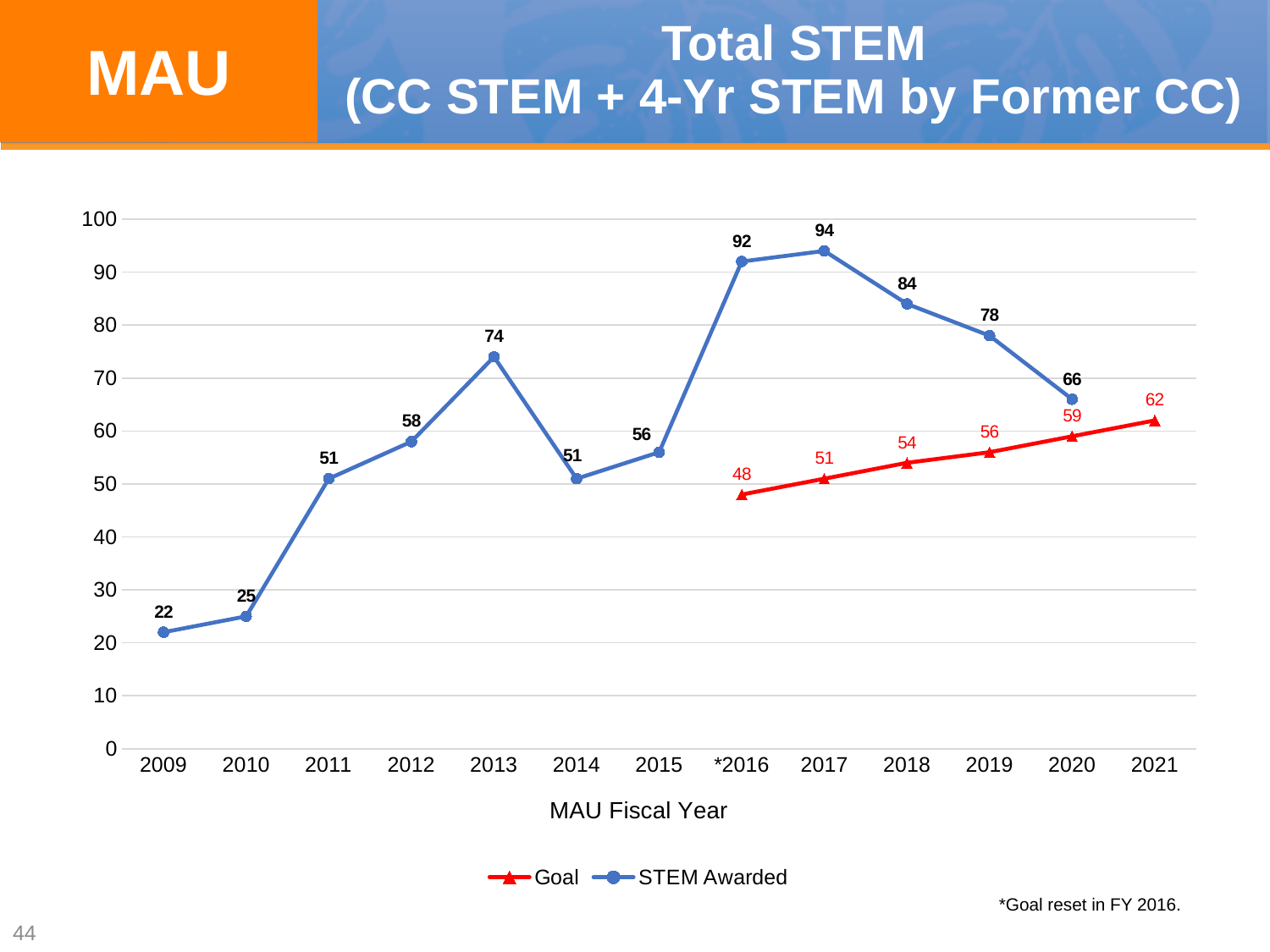
What is the STEM Awarded value for 2017? 94 Does the Goal series rise or fall from *2016 to 2021? rise What is the Goal value for 2019? 56 How many fiscal years are shown on the x axis? 13 Which is larger in 2018, the STEM Awarded value or the Goal value? STEM Awarded What is the difference between the STEM Awarded value and the Goal value in 2020? 7 What is the label of the x axis? MAU Fiscal Year Is the STEM Awarded value for 2013 greater or less than 70? greater Which year has the highest STEM Awarded value? 2017 What kind of chart is shown on the slide? line chart How many series does the legend list? 2 Which year has the lowest STEM Awarded value? 2009